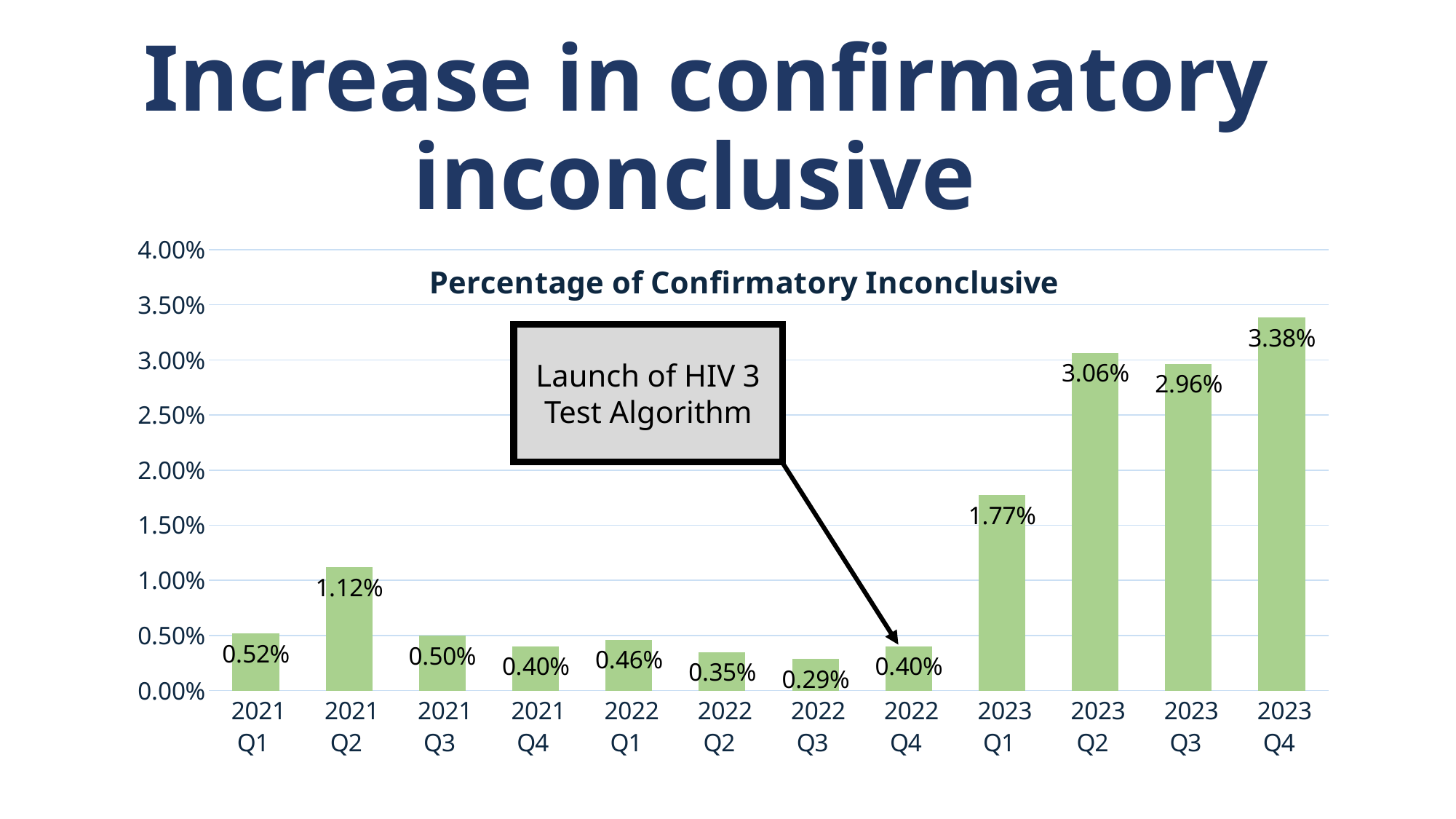
What is the title of the chart? Percentage of Confirmatory Inconclusive Which quarter has the highest percentage of confirmatory inconclusive? 2023 Q4 Which quarter has the lowest percentage of confirmatory inconclusive? 2022 Q3 What is the percentage of confirmatory inconclusive for 2022 Q3? 0.29% Which is larger, the percentage for 2023 Q2 or 2023 Q3? 2023 Q2 What is the percentage of confirmatory inconclusive for 2021 Q2? 1.12% How many quarters are shown on the x axis? 12 Is the value for 2023 Q1 greater or less than 1.50%? greater What is the percentage of confirmatory inconclusive for 2023 Q4? 3.38% What kind of chart is shown on the slide? Bar chart What is the difference between the percentage for 2023 Q4 and 2023 Q1? 1.61% What event does the annotation box on the chart point to at 2022 Q4? Launch of HIV 3 Test Algorithm